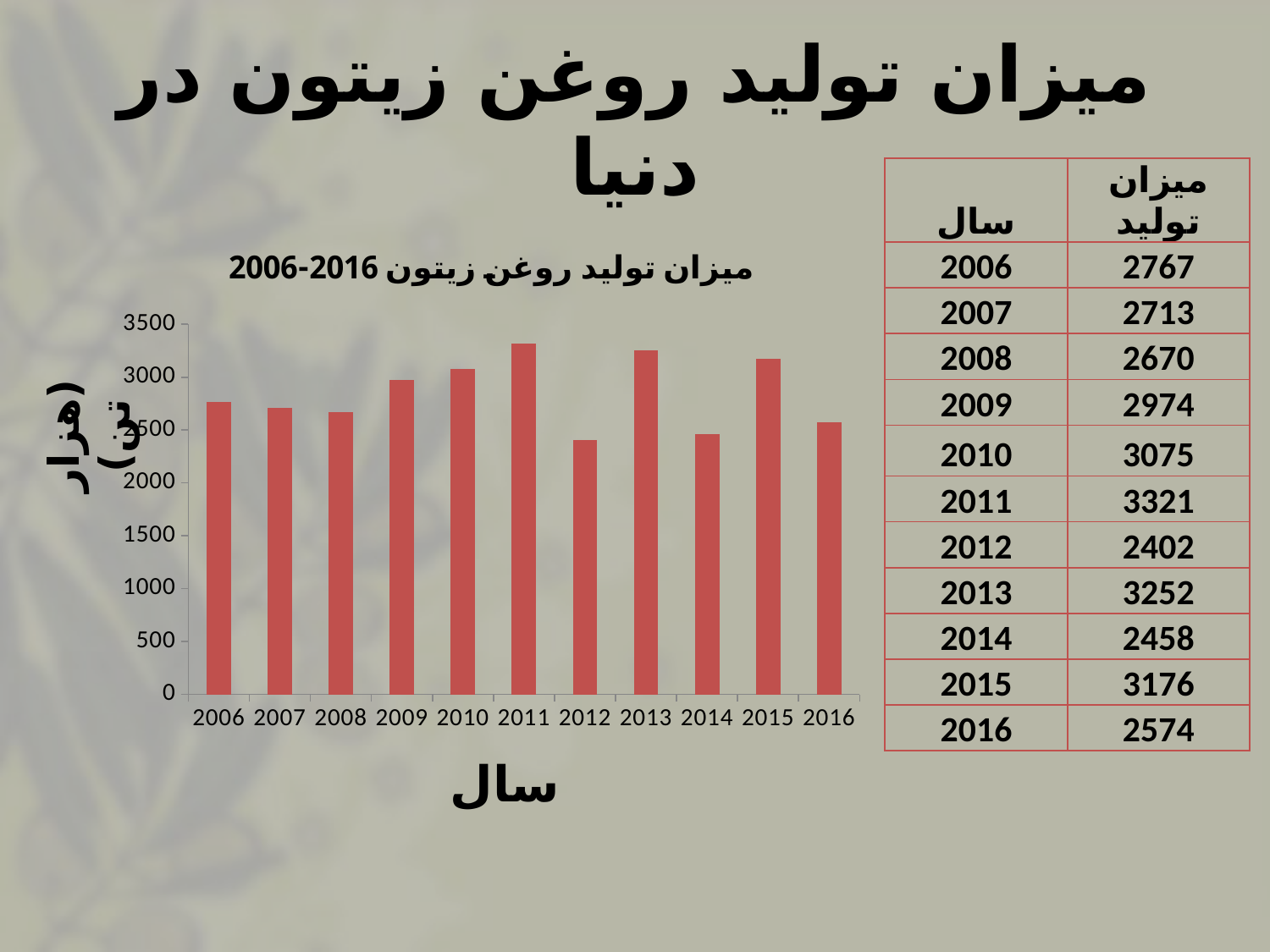
What is the title of the chart? میزان تولید روغن زیتون 2006-2016 Is the value for 2010 greater or less than 3000? greater According to the slide, what is the olive oil production value for 2011? 3321 Which year has the lowest olive oil production in the chart? 2012 What kind of chart is shown on the slide? bar chart Do the bars rise or fall from 2006 to 2008? fall Is the value for 2014 greater or less than 2500? less According to the slide, what is the olive oil production value for 2012? 2402 Which year has the highest olive oil production in the chart? 2011 How many years (bars) are plotted in the chart? 11 Which year has a larger production value, 2013 or 2015? 2013 What is the difference between the production values for 2011 and 2012? 919